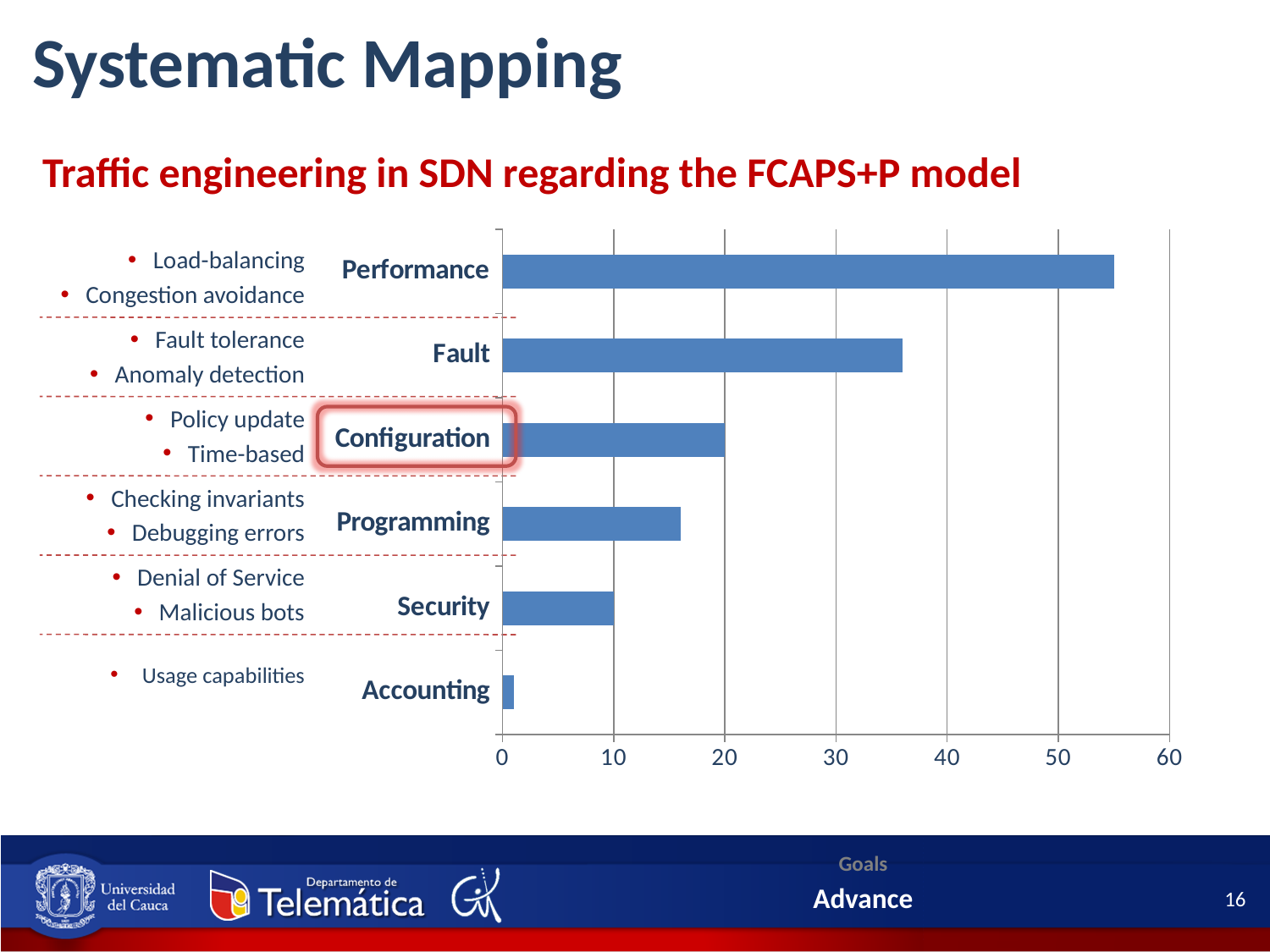
Which category has the lowest value? Accounting Which category has the highest value? Performance Which has a larger value, Security or Programming? Programming Is the value for Performance greater or less than 50? greater Is the value for Accounting greater or less than 10? less Which has a larger value, Fault or Configuration? Fault How many categories does the chart show? 6 Is the value for Fault greater or less than 40? less What kind of chart is shown on the slide? bar chart Which category label on the chart is highlighted with a red box? Configuration Do the bar values increase or decrease going from Performance at the top to Accounting at the bottom? decrease